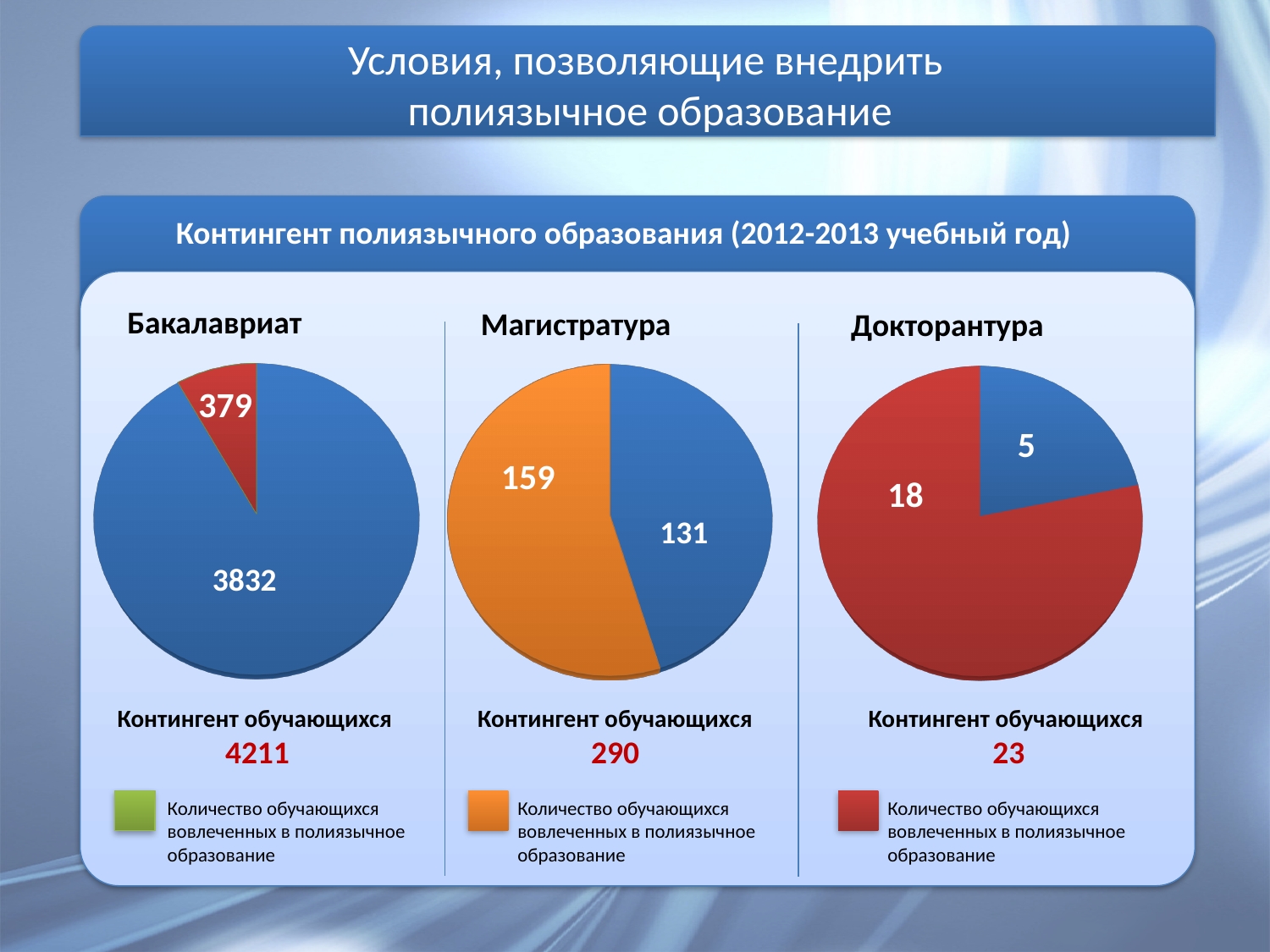
In the Докторантура pie chart, which slice is larger, the red one or the blue one? the red one In the Бакалавриат pie chart, what is the value of the larger (blue) slice? 3832 In the Докторантура pie chart, what is the value of the red slice? 18 In the Магистратура pie chart, what is the value of the blue slice? 131 In the Магистратура pie chart, what is the value of the orange slice? 159 In the Бакалавриат pie chart, what is the value of the smaller (red) slice? 379 What kind of chart is used for Бакалавриат on the slide? pie chart In the Магистратура pie chart, what is the difference between the orange slice and the blue slice? 28 How many slices does the Докторантура pie chart have? 2 What total contingent of students (Контингент обучающихся) is shown under the Магистратура pie chart? 290 In the Бакалавриат pie chart, what is the difference between the two slices? 3453 How many pie charts are shown on the slide? 3